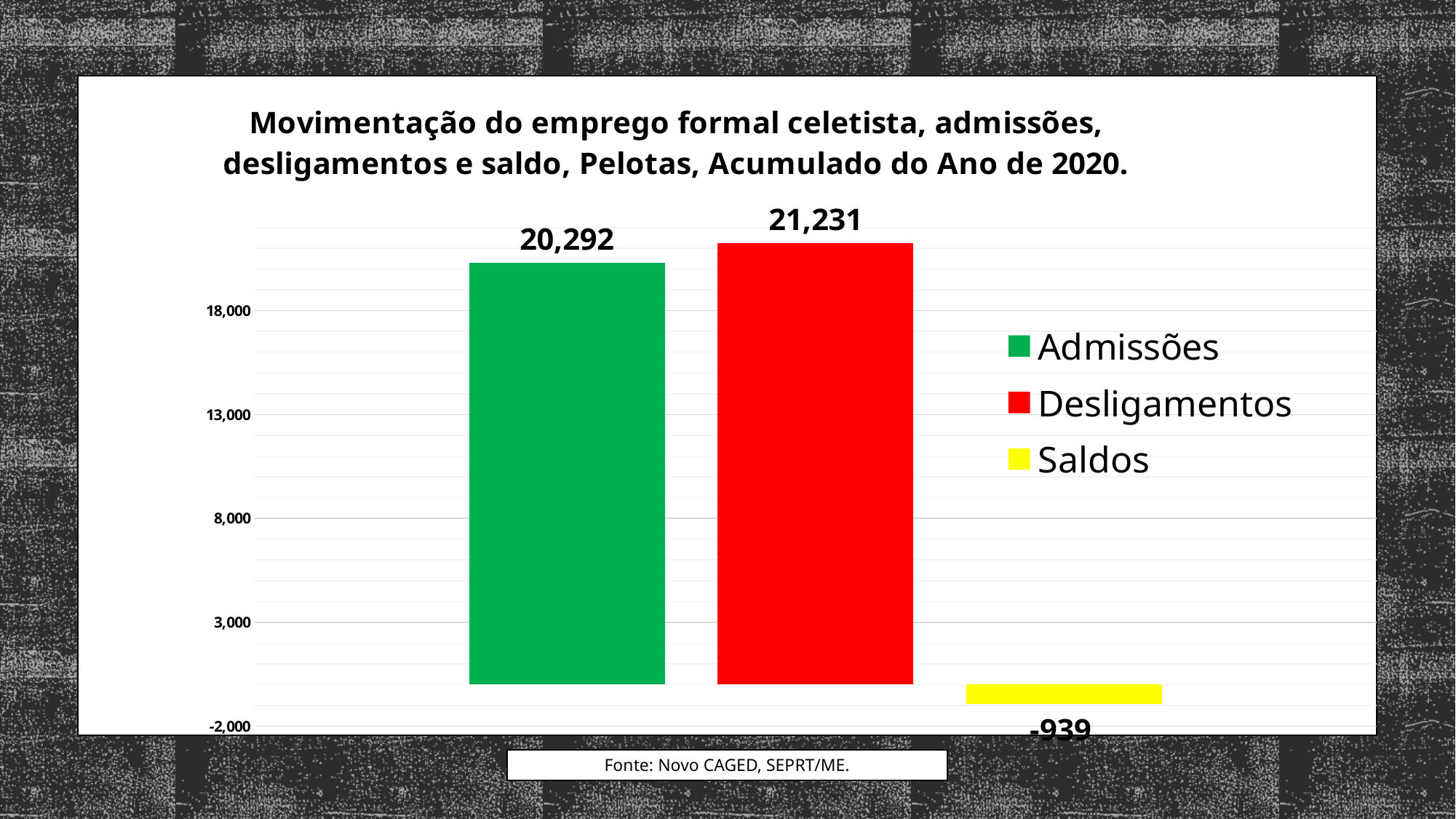
How many series does the legend list? 3 What kind of chart is shown on the slide? bar chart Is the value for Admissões greater or less than 18,000? greater What source is cited below the chart? Novo CAGED, SEPRT/ME. Which series has the highest value? Desligamentos Which series has the lowest value? Saldos What is the value for Saldos? -939 What is the value for Desligamentos? 21,231 What colour is the bar for Saldos? yellow Which is larger, Admissões or Desligamentos? Desligamentos What is the value for Admissões? 20,292 What is the difference between Desligamentos and Admissões? 939